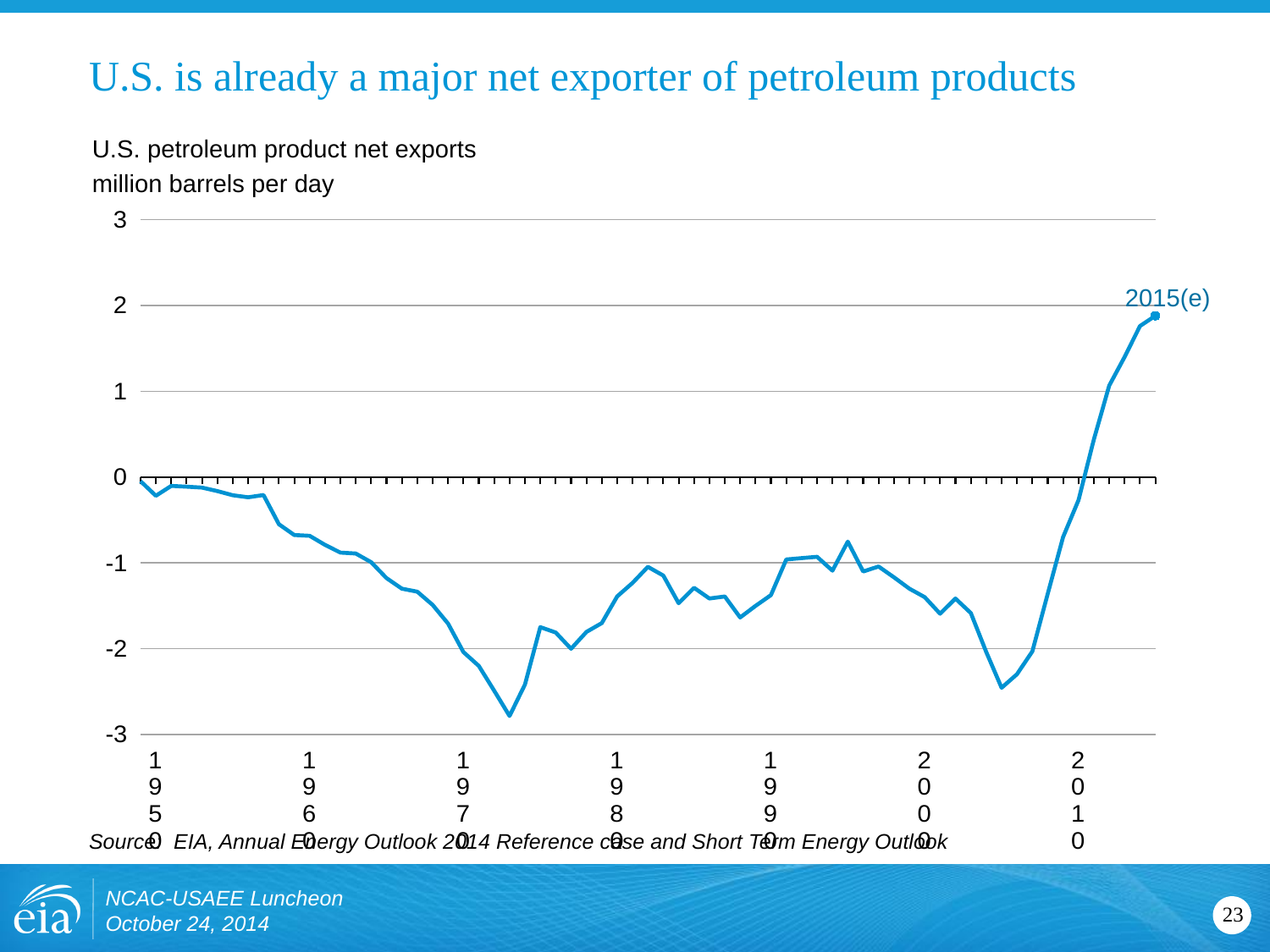
Is the value for 1950 greater or less than -1? greater How many year labels are shown on the x axis? 7 What label annotates the final point of the line? 2015(e) Is the value for 1960 greater or less than 0? less Is the lowest point on the line greater or less than -2? less Between 2010 and 2015(e), does the line rise or fall? rise Between 1950 and 1970, does the line generally rise or fall? fall What is the title of the chart? U.S. petroleum product net exports What kind of chart is shown on the slide? line chart